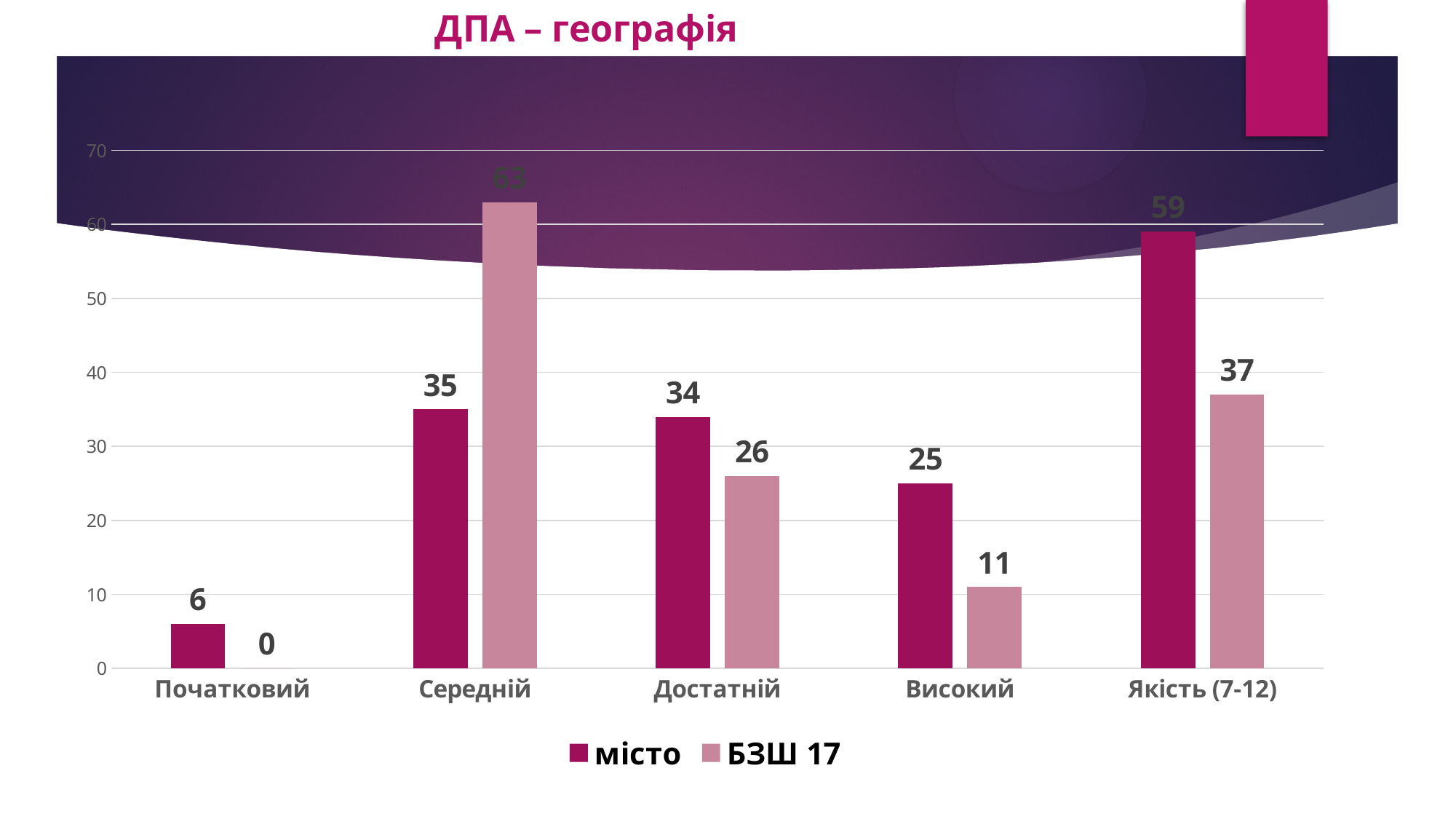
What is the difference between місто and БЗШ 17 in the Якість (7-12) category? 22 In the Достатній category, which series has the larger value, місто or БЗШ 17? місто What kind of chart is shown on the slide? bar chart What is the value for місто in the Середній category? 35 Which category has the highest value for the БЗШ 17 series? Середній How many categories are shown on the x axis? 5 Is the value for місто in the Якість (7-12) category greater or less than 50? greater What is the value for БЗШ 17 in the Високий category? 11 How many series does the legend list? 2 What is the title of the chart? ДПА – географія Which category has the lowest value for the місто series? Початковий What is the value for БЗШ 17 in the Початковий category? 0